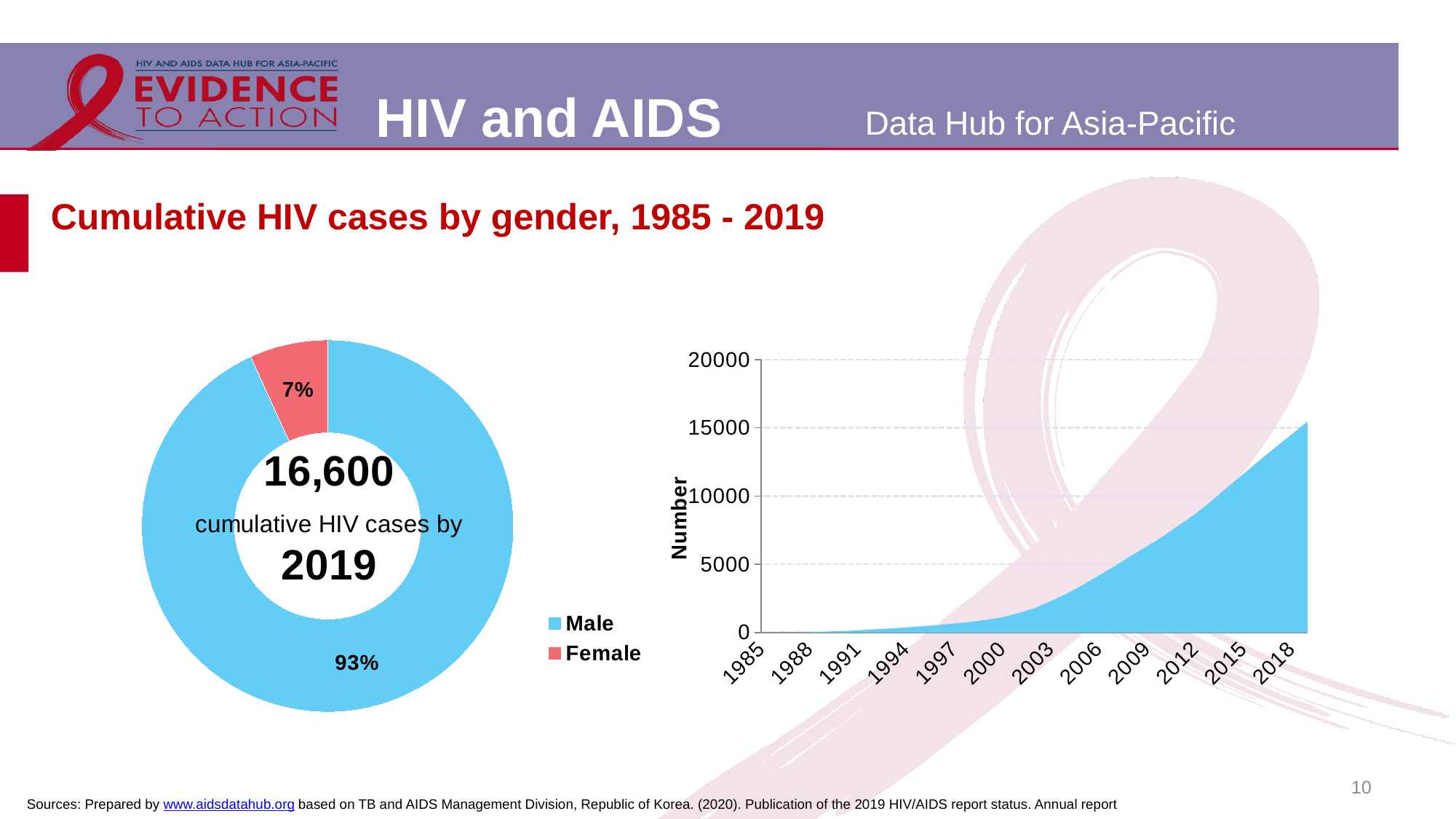
On the area chart on the right, is the value for 2015 greater or less than 5000? greater On the donut chart, which gender has the larger share of cumulative HIV cases? Male What kind of chart is the chart on the left of the slide? Donut (pie) chart What is the label of the vertical axis on the area chart on the right? Number What kind of chart is the chart on the right of the slide? Area chart How many entries does the legend of the donut chart list? 2 On the donut chart, what is the difference in percentage points between the Male and Female shares? 86% On the donut chart, what total number of cumulative HIV cases by 2019 is shown in the centre? 16,600 On the donut chart, what share of cumulative HIV cases is Male? 93% On the area chart on the right, is the value for 2009 greater or less than 10000? less On the area chart on the right, do the values rise or fall from 1985 to 2018? Rise On the donut chart, what share of cumulative HIV cases is Female? 7%